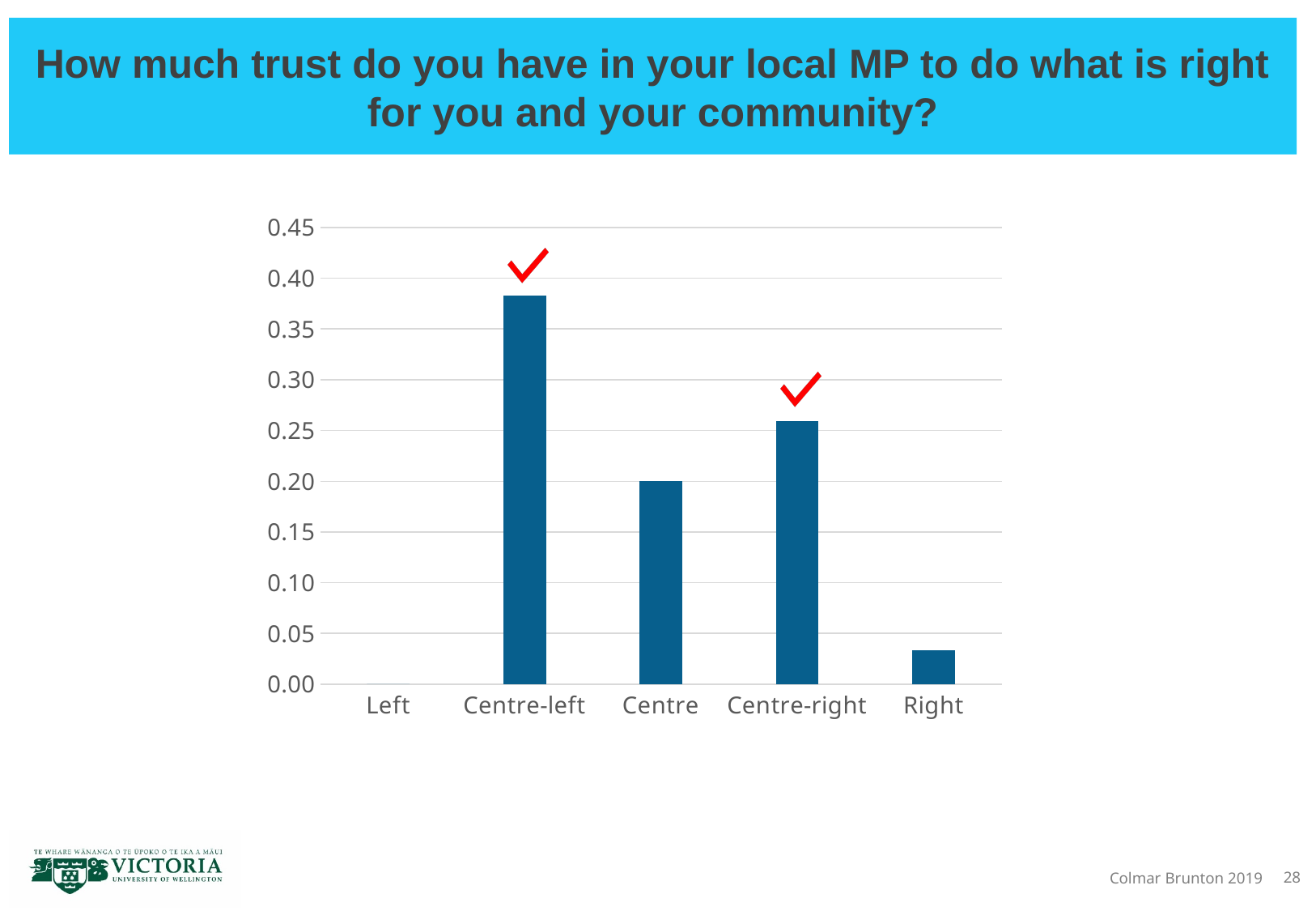
Is the value for Centre-right greater or less than 0.25? greater Which is larger, the value for Right or the value for Centre? Centre Is the value for Right greater or less than 0.05? less Which category has the lowest value in the chart? Left Which category has the highest value in the chart? Centre-left What kind of chart is shown on the slide? bar chart Is the value for Centre-left greater or less than 0.35? greater Which is larger, the value for Centre or the value for Centre-right? Centre-right What is the title of the slide containing the chart? How much trust do you have in your local MP to do what is right for you and your community? Which two bars in the chart are marked with a red tick? Centre-left and Centre-right How many categories are shown on the x axis of the chart? 5